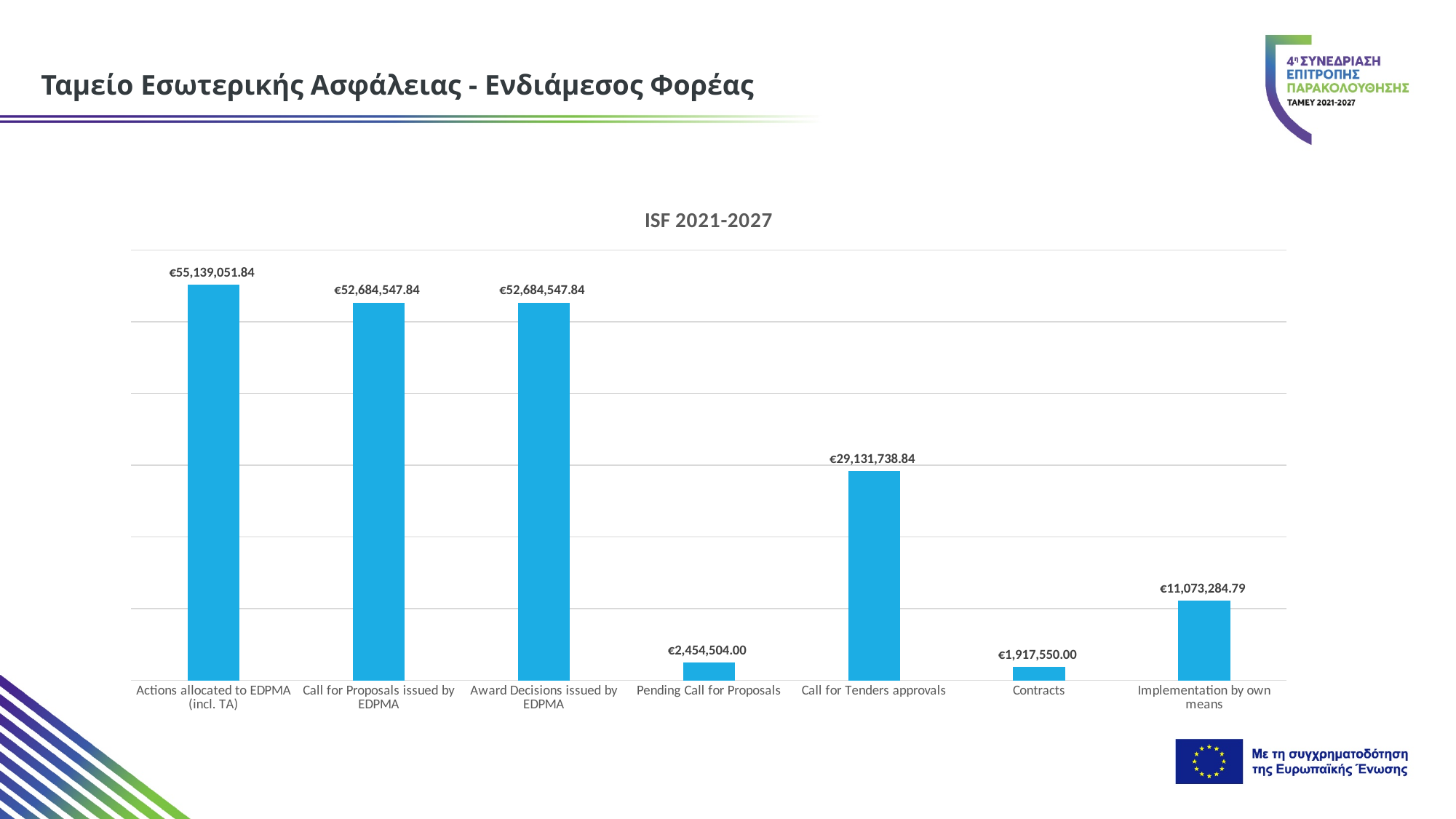
Which is larger, Call for Tenders approvals or Implementation by own means? Call for Tenders approvals What kind of chart is shown? Bar chart How many categories are shown on the chart? 7 What is the difference between Actions allocated to EDPMA (incl. TA) and Call for Proposals issued by EDPMA? €2,454,504.00 What is the value for Actions allocated to EDPMA (incl. TA)? €55,139,051.84 What is the value for Pending Call for Proposals? €2,454,504.00 What is the title of the chart? ISF 2021-2027 What is the difference between Pending Call for Proposals and Contracts? €536,954.00 Which category has the lowest value? Contracts Which category has the highest value? Actions allocated to EDPMA (incl. TA) What is the value for Implementation by own means? €11,073,284.79 What is the value for Call for Tenders approvals? €29,131,738.84